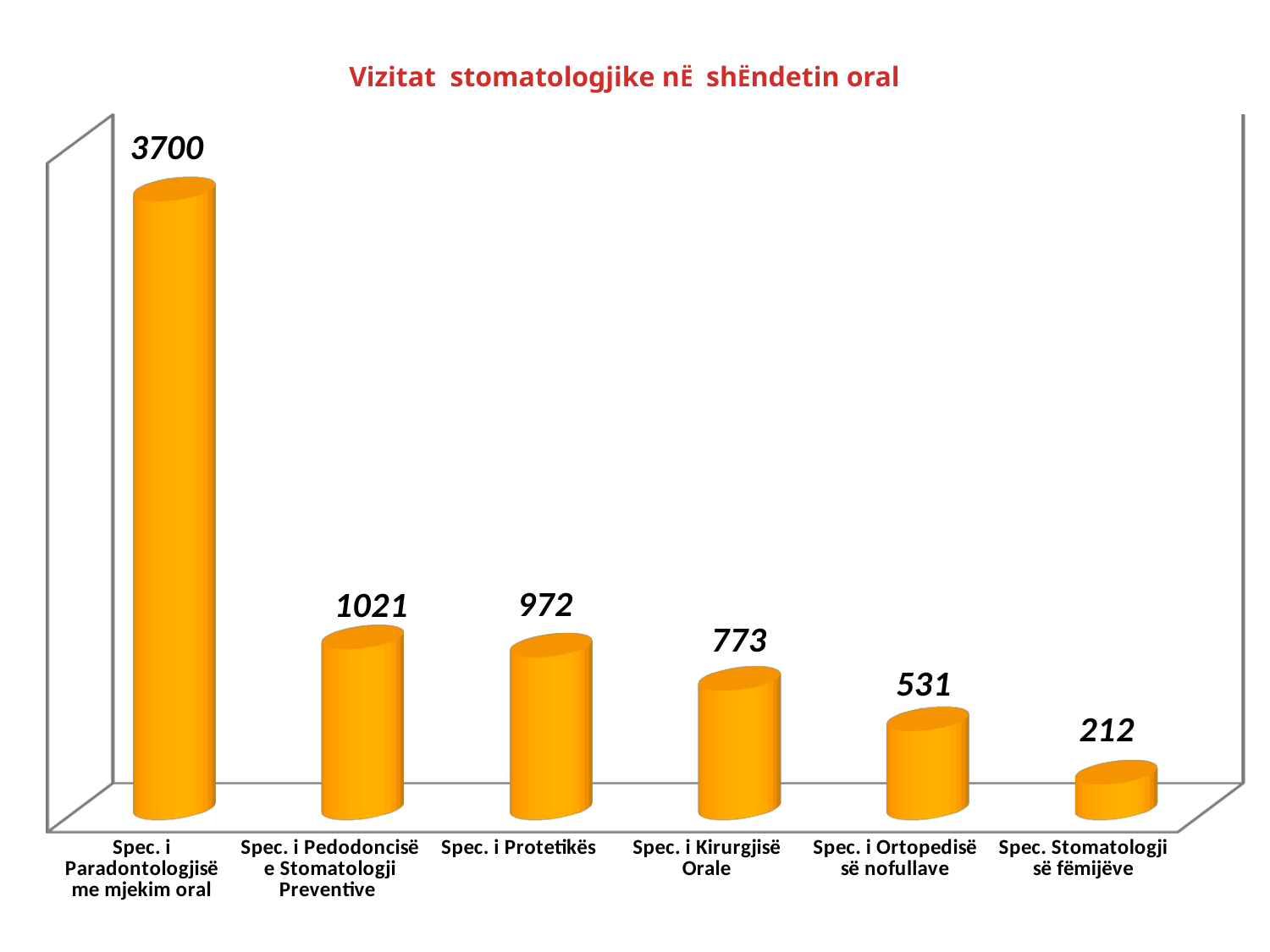
What is the difference between the values for Spec. i Kirurgjisë Orale and Spec. Stomatologji së fëmijëve? 561 What is the difference between the values for Spec. i Pedodoncisë e Stomatologji Preventive and Spec. i Protetikës? 49 Which category has the lowest value? Spec. Stomatologji së fëmijëve Do the values rise or fall from left to right along the x axis? Fall How many categories are shown in the chart? 6 Which is larger, the value for Spec. i Kirurgjisë Orale or the value for Spec. i Ortopedisë së nofullave? Spec. i Kirurgjisë Orale What is the value for Spec. i Paradontologjisë me mjekim oral? 3700 What kind of chart is shown on the slide? Bar chart What is the value for Spec. i Protetikës? 972 What is the title of the chart? Vizitat stomatologjike në shëndetin oral What is the value for Spec. i Ortopedisë së nofullave? 531 Which category has the highest value? Spec. i Paradontologjisë me mjekim oral